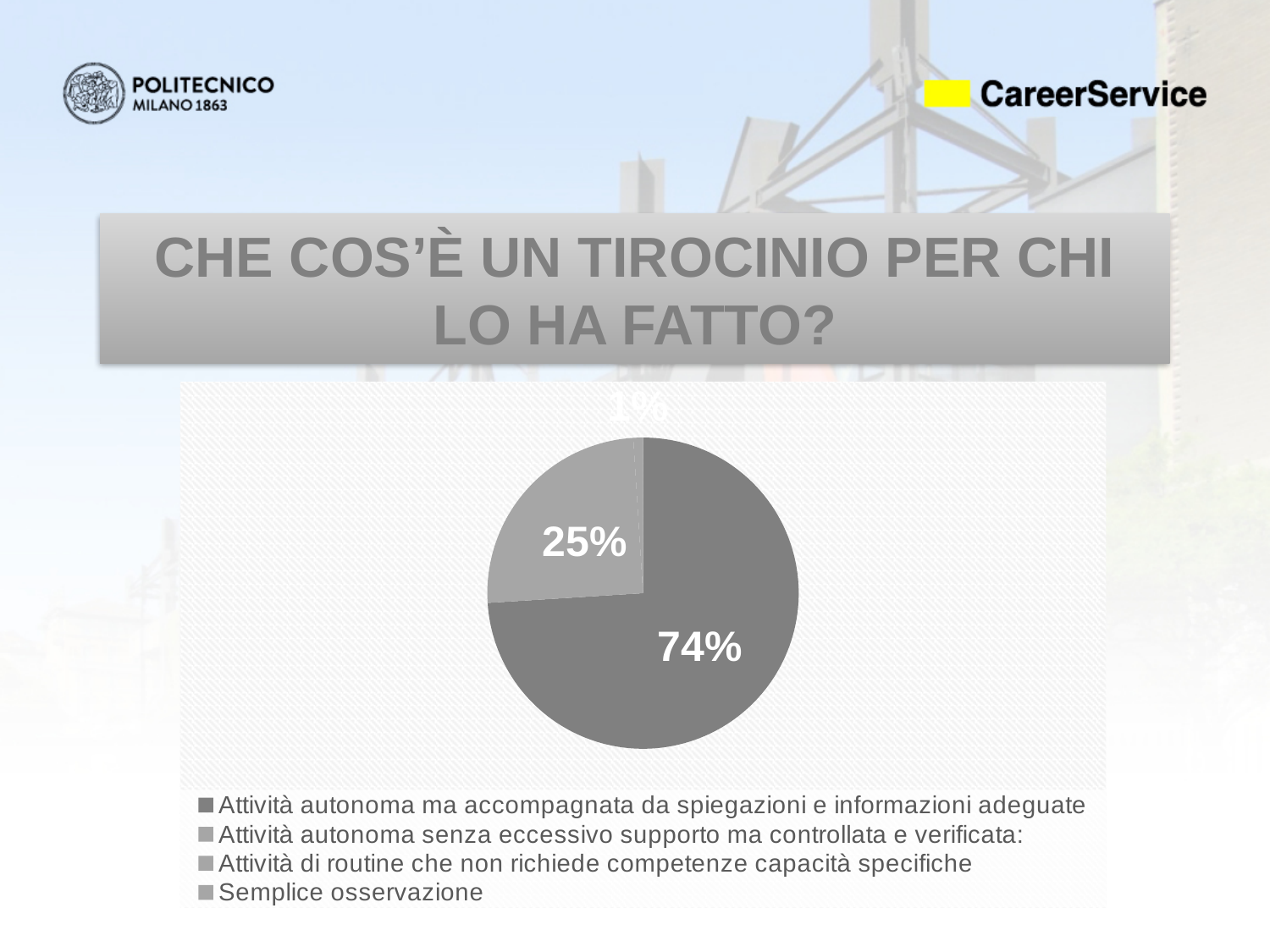
What is the difference between the 74% slice and the 25% slice? 49% What is the share of the pie taken by the darkest slice, corresponding to 'Attività autonoma ma accompagnata da spiegazioni e informazioni adeguate'? 74% What is the difference between the 25% slice and the 1% slice? 24% What is the value of the second-largest slice in the pie chart? 25% How many entries does the legend of the pie chart list? 4 What is the value of the largest slice in the pie chart? 74% How many percentage labels are printed on the pie chart? 3 What is the value of the smallest labelled slice in the pie chart? 1% What kind of chart is shown on the slide? pie chart What is the last entry listed in the legend of the pie chart? Semplice osservazione Which is larger, the slice labelled 25% or the slice labelled 74%? 74% What is the title shown above the pie chart? CHE COS'È UN TIROCINIO PER CHI LO HA FATTO?